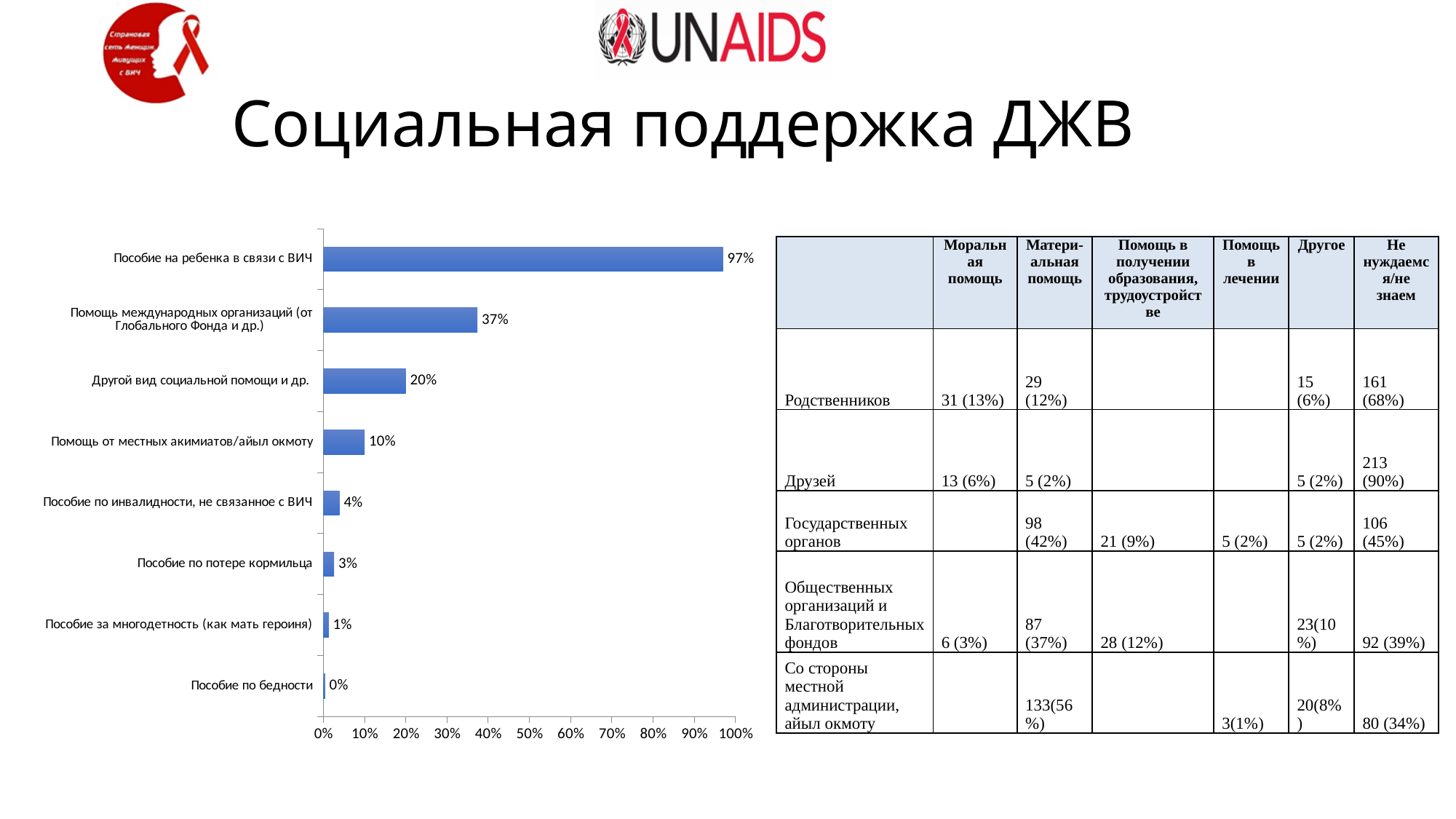
How many categories are shown in the bar chart? 8 What is the value for "Помощь международных организаций (от Глобального Фонда и др.)"? 37% What is the value for "Пособие на ребенка в связи с ВИЧ"? 97% What is the difference between the values for "Пособие по инвалидности, не связанное с ВИЧ" and "Пособие за многодетность (как мать героиня)"? 3% Which category has the lowest value in the bar chart? Пособие по бедности Which is larger: the value for "Другой вид социальной помощи и др." or the value for "Помощь от местных акимиатов/айыл окмоту"? Другой вид социальной помощи и др. Which category has the highest value in the bar chart? Пособие на ребенка в связи с ВИЧ What is the value for "Помощь от местных акимиатов/айыл окмоту"? 10% What is the title of the slide containing the bar chart? Социальная поддержка ДЖВ What type of chart is shown on the slide? bar chart What is the value for "Пособие по потере кормильца"? 3% What is the difference between the values for "Пособие на ребенка в связи с ВИЧ" and "Помощь международных организаций (от Глобального Фонда и др.)"? 60%